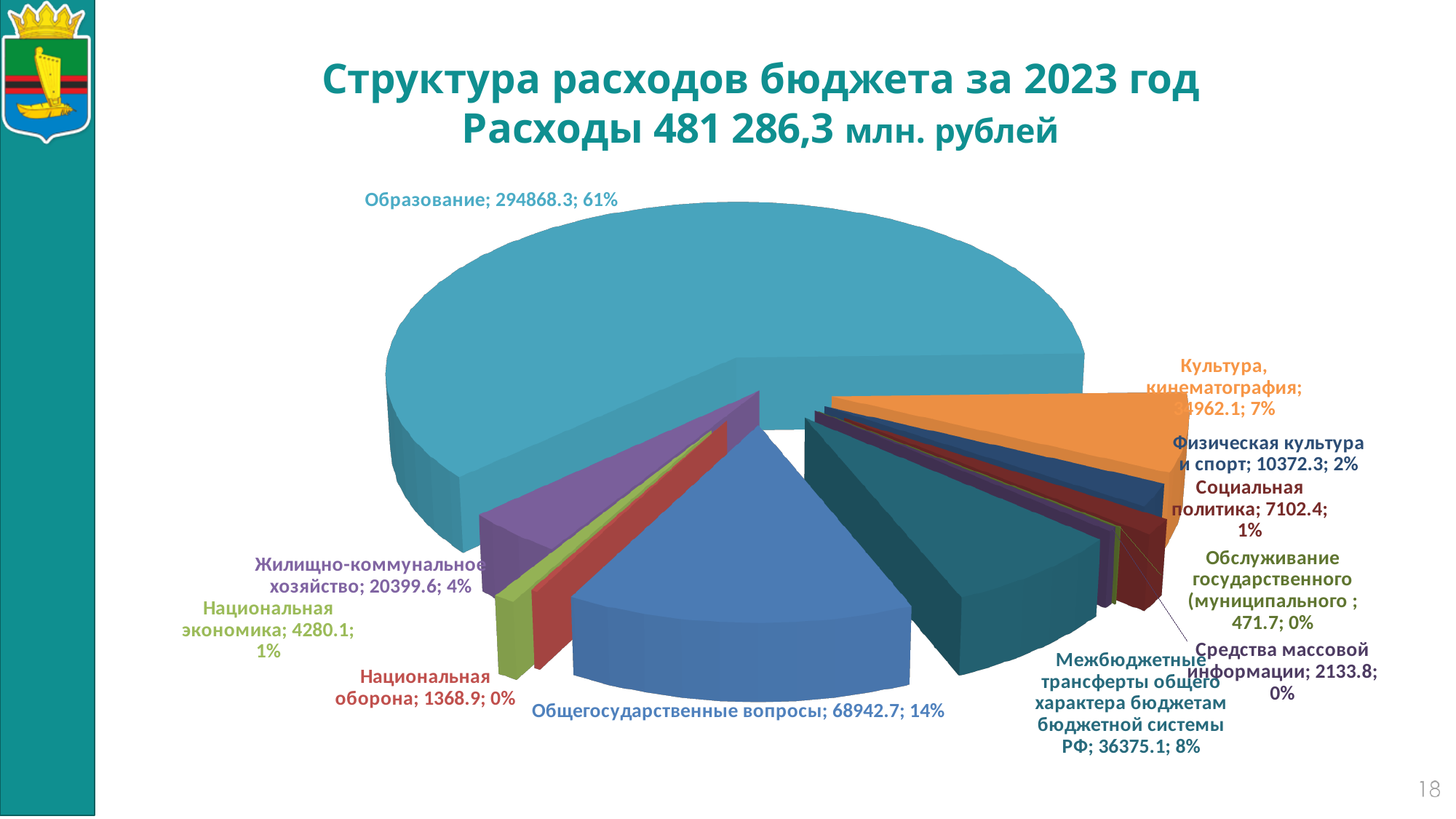
Which category has the smallest value? Обслуживание государственного (муниципального Which is larger: the value for Физическая культура и спорт or the value for Социальная политика? Физическая культура и спорт What type of chart is shown on the slide? Pie chart What is the difference between the values for Общегосударственные вопросы and Жилищно-коммунальное хозяйство? 48543.1 What is the value for Образование? 294868.3 What is the value for Жилищно-коммунальное хозяйство? 20399.6 Which category has the largest slice of the pie? Образование How many categories are shown in the pie chart? 11 What share of the pie does Межбюджетные трансферты общего характера бюджетам бюджетной системы РФ represent? 8% What total expenditure amount is stated in the slide title? 481 286,3 млн. рублей What is the value for Общегосударственные вопросы? 68942.7 What share of the pie does Образование represent? 61%